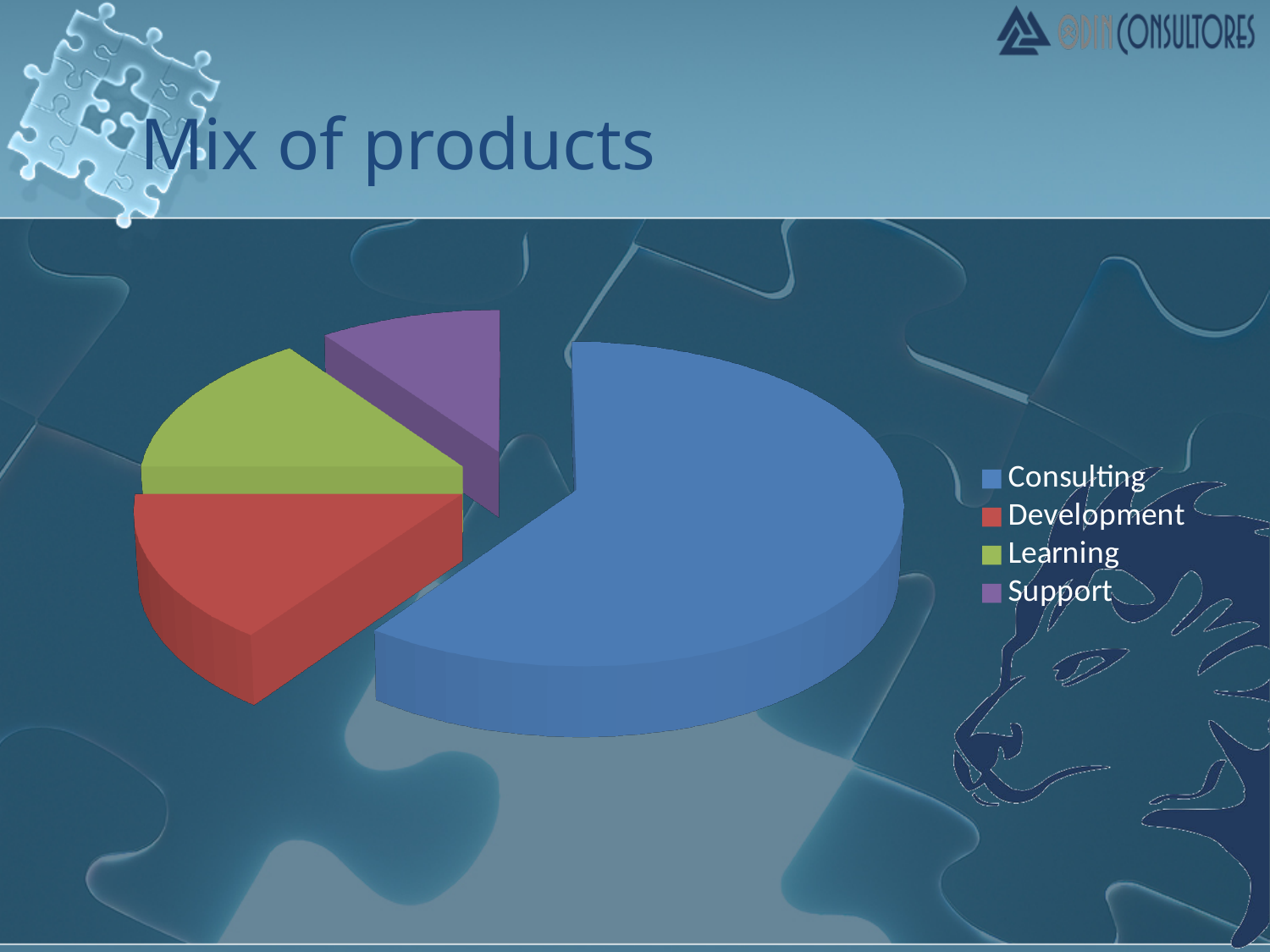
How many entries does the legend list? 4 What kind of chart is shown on the slide? pie chart Which category is shown in green? Learning How many slices does the pie chart have? 4 Which category has the smallest slice of the pie? Support What is the title of the chart slide? Mix of products Which category has the largest slice of the pie? Consulting Which slice is larger, Consulting or Support? Consulting Which slice is larger, Consulting or Development? Consulting What colour is the Consulting slice? blue